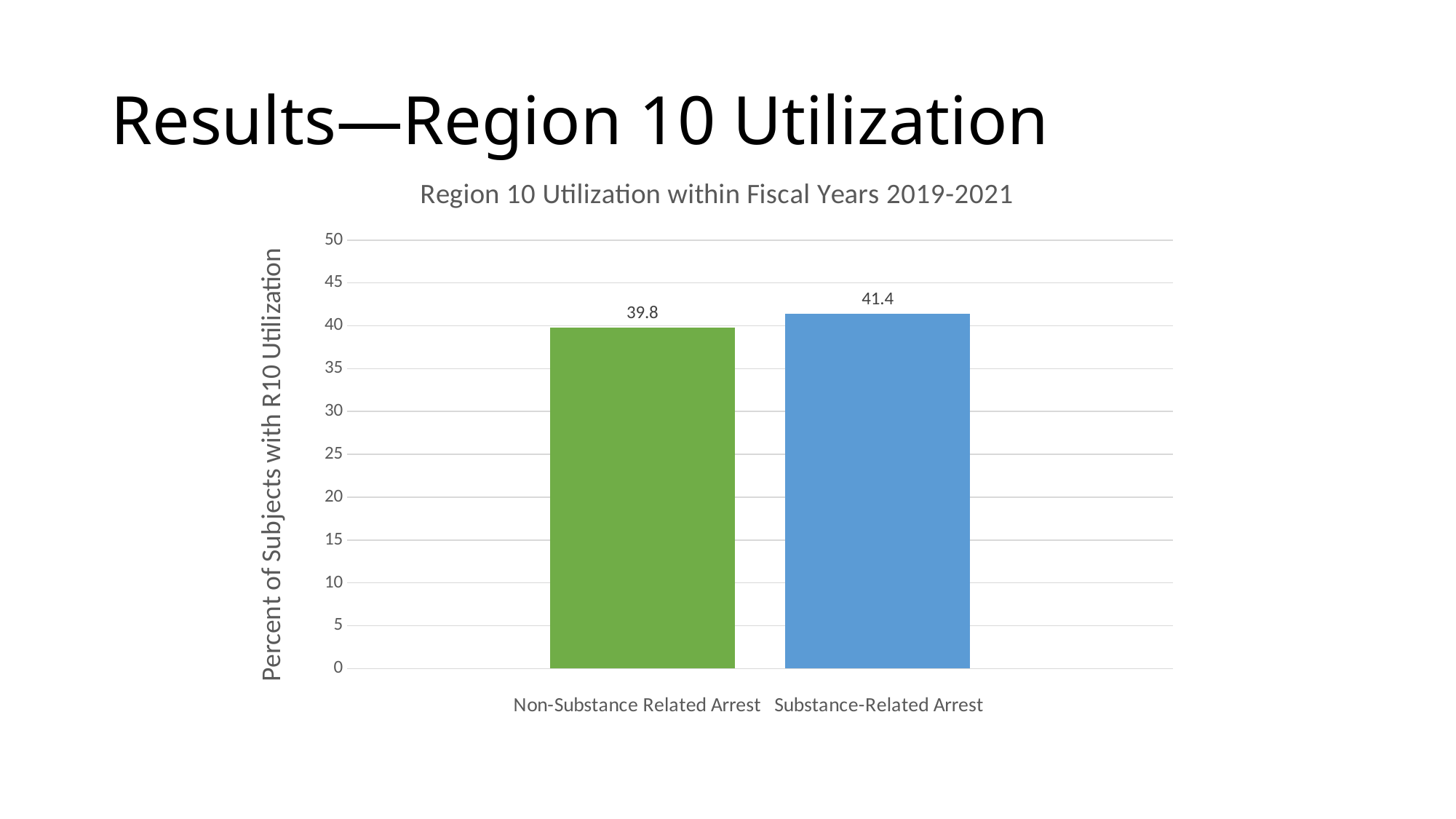
Which category has the lowest value? Non-Substance Related Arrest Is the value for Non-Substance Related Arrest greater or less than 40? less Which is larger, the value for Non-Substance Related Arrest or the value for Substance-Related Arrest? Substance-Related Arrest Which category has the highest value? Substance-Related Arrest What is the label of the y axis? Percent of Subjects with R10 Utilization What is the value for Non-Substance Related Arrest? 39.8 What is the value for Substance-Related Arrest? 41.4 What is the difference between the values for Substance-Related Arrest and Non-Substance Related Arrest? 1.6 What kind of chart is shown on the slide? Bar chart What is the title of the chart? Region 10 Utilization within Fiscal Years 2019-2021 Is the value for Substance-Related Arrest greater or less than 40? greater How many categories are shown on the x axis? 2